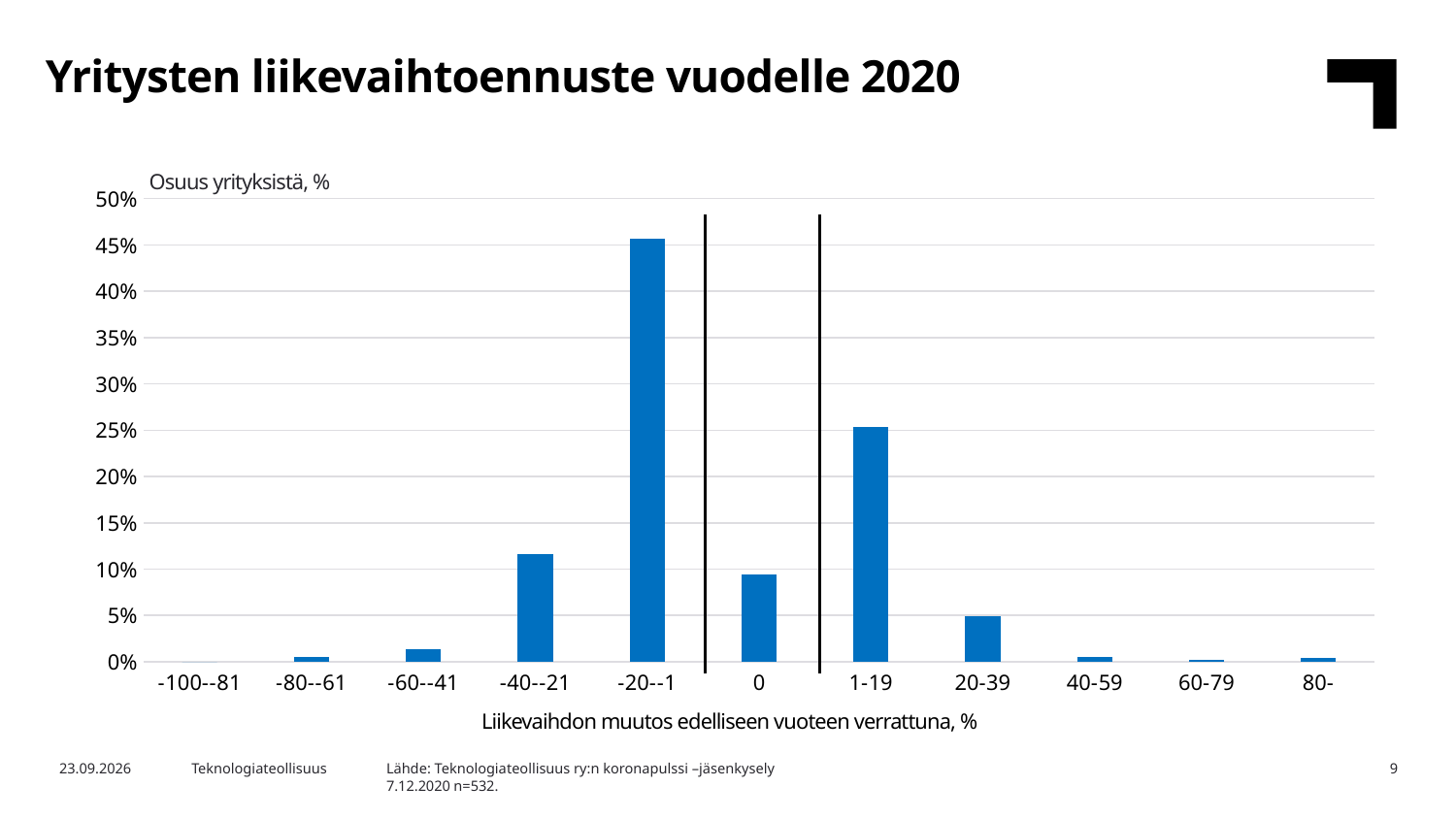
Is the value for -40--21 greater or less than 10%? greater What is the title of the slide? Yritysten liikevaihtoennuste vuodelle 2020 Which category has the highest share of companies? -20--1 Which is larger, the value for 0 or the value for 20-39? 0 What kind of chart is shown on the slide? bar chart Is the value for 20-39 greater or less than 10%? less What is the label of the x axis of the chart? Liikevaihdon muutos edelliseen vuoteen verrattuna, % Is the value for -20--1 greater or less than 40%? greater How many categories are shown on the x axis of the chart? 11 Which is larger, the value for 1-19 or the value for -40--21? 1-19